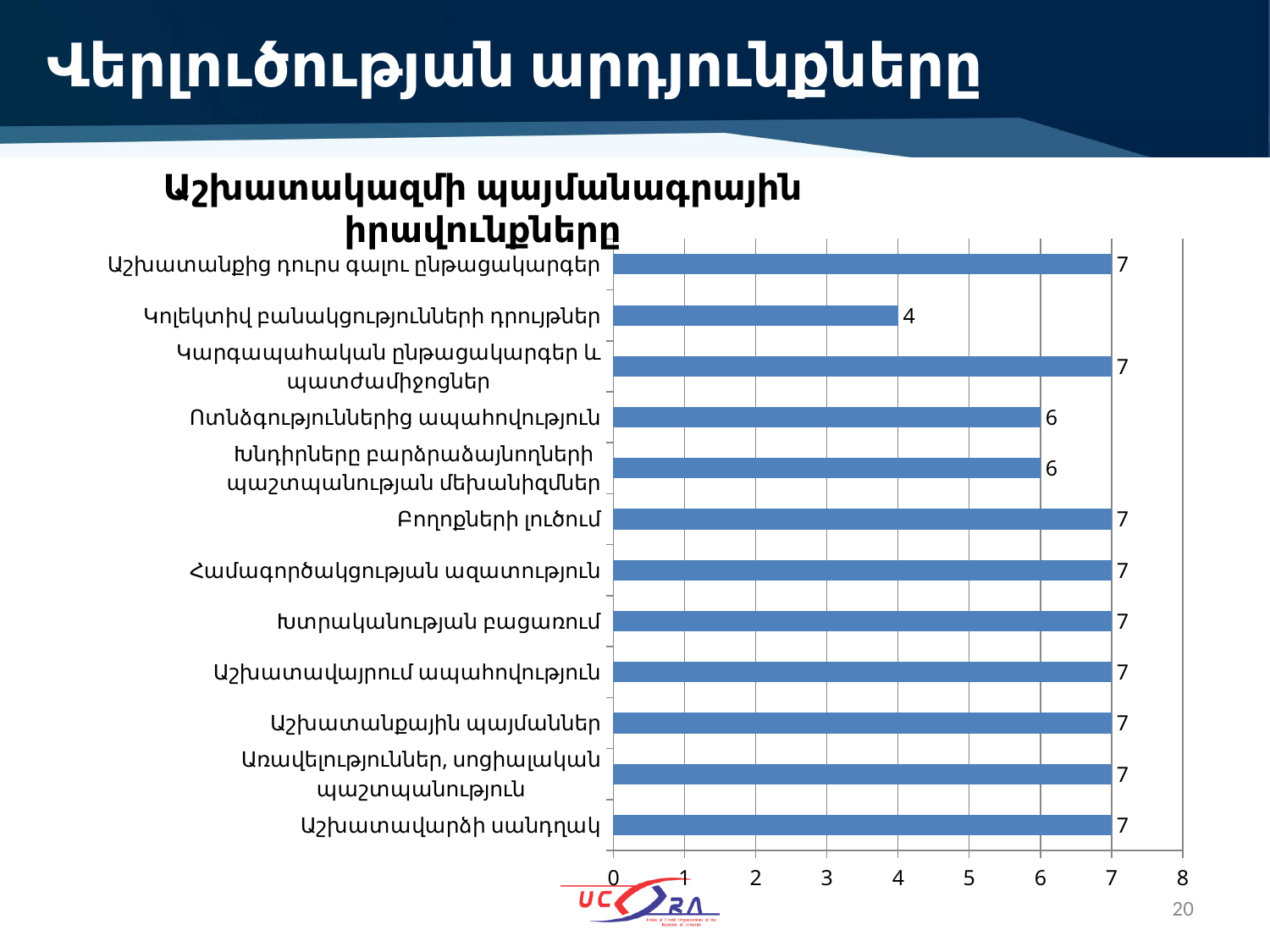
What is the title of the chart? Աշխատակազմի պայմանագրային իրավունքները What is the difference between the values for Բողոքների լուծում and Ոտնձգություններից ապահովություն? 1 What value is shown for Աշխատավարձի սանդղակ? 7 How many categories are shown in the chart? 12 Is the value for Կոլեկտիվ բանակցությունների դրույթներ greater or less than 5? less Which is larger: the value for Խտրականության բացառում or the value for Կոլեկտիվ բանակցությունների դրույթներ? Խտրականության բացառում What value is shown for Ոտնձգություններից ապահովություն? 6 What is the difference between the values for Աշխատանքից դուրս գալու ընթացակարգեր and Կոլեկտիվ բանակցությունների դրույթներ? 3 What value is shown for Կոլեկտիվ բանակցությունների դրույթներ? 4 Which category has the lowest value? Կոլեկտիվ բանակցությունների դրույթներ What value is shown for Խնդիրները բարձրաձայնողների պաշտպանության մեխանիզմներ? 6 What kind of chart is shown on the slide? bar chart